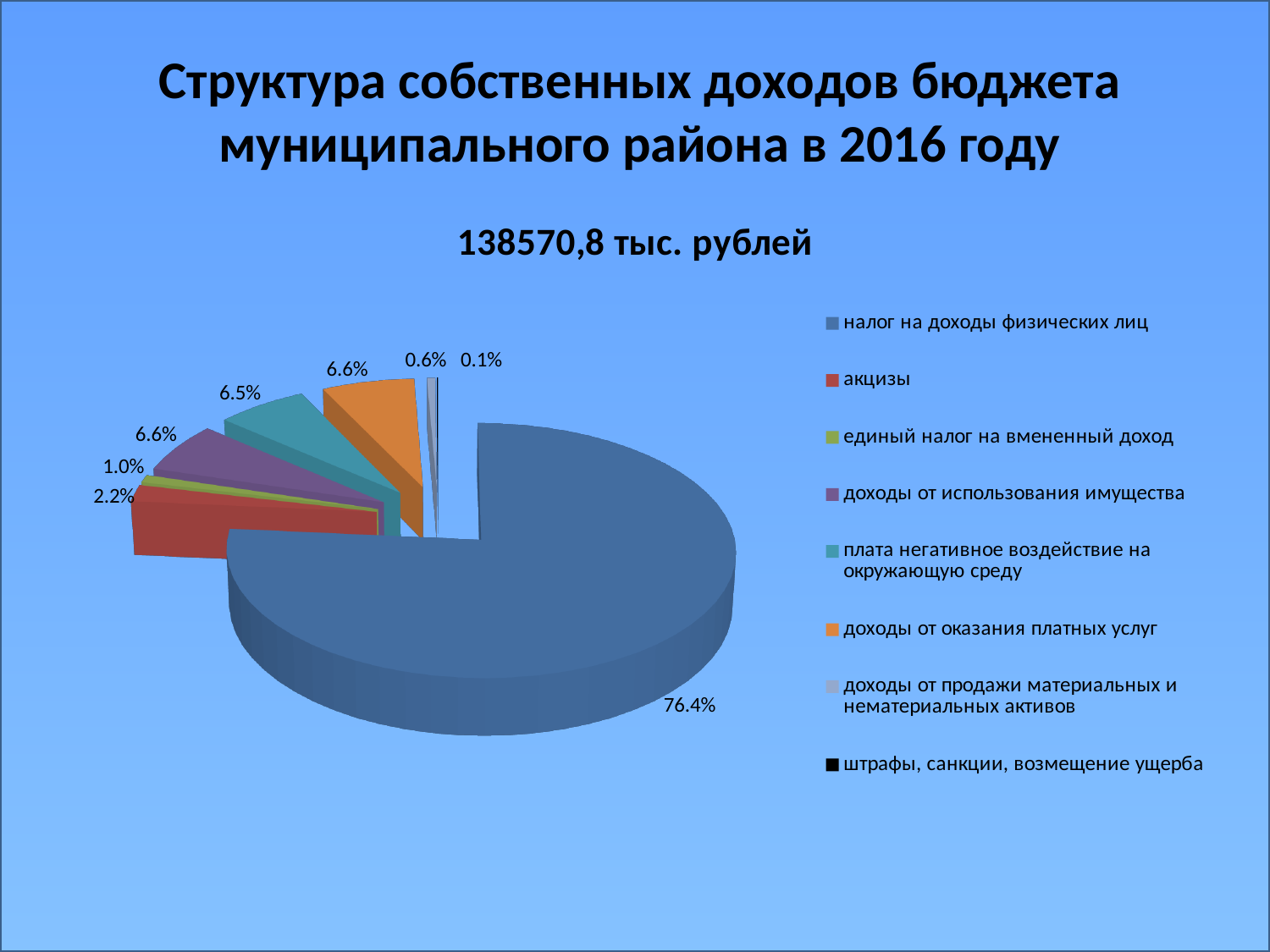
What total amount in thousand rubles is shown above the chart? 138570,8 тыс. рублей What share of the pie does плата негативное воздействие на окружающую среду have? 6.5% What share of the pie does доходы от продажи материальных и нематериальных активов have? 0.6% What share of the pie does акцизы have? 2.2% What share of the pie does налог на доходы физических лиц have? 76.4% Which is larger: the share for доходы от использования имущества or the share for акцизы? доходы от использования имущества Which category has the largest share of the pie? налог на доходы физических лиц Which category has the smallest share of the pie? штрафы, санкции, возмещение ущерба What kind of chart is shown on the slide? pie chart What is the difference in percentage points between налог на доходы физических лиц and акцизы? 74.2 What share of the pie does единый налог на вмененный доход have? 1.0% How many slices does the pie chart have? 8